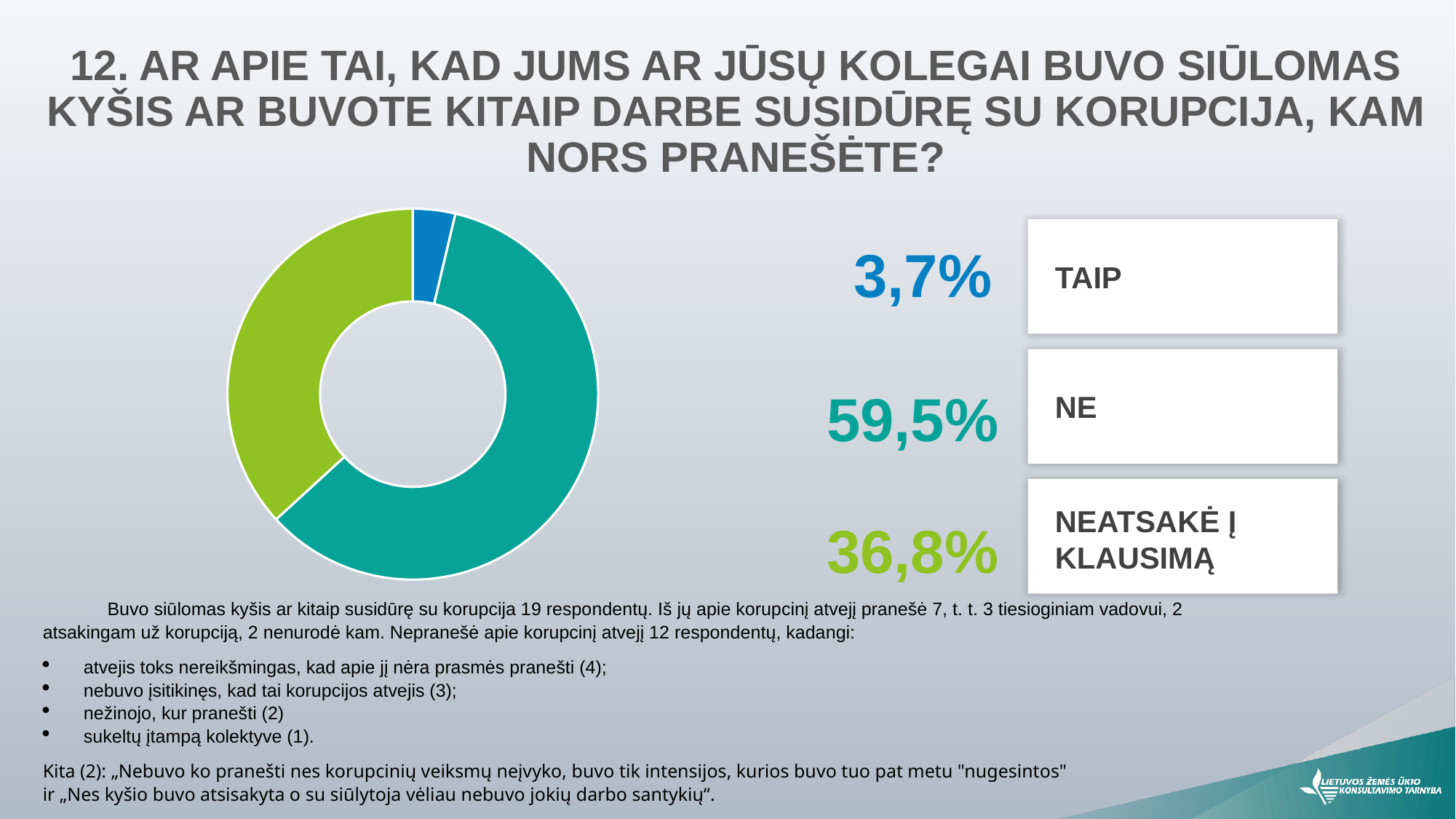
What is the difference in percentage points between the "NEATSAKĖ Į KLAUSIMĄ" and "TAIP" shares? 33,1 What colour is the slice representing "TAIP"? Blue Which answer category has the largest share in the chart? NE How many answer categories are shown in the chart? 3 What is the difference in percentage points between the "NE" and "NEATSAKĖ Į KLAUSIMĄ" shares? 22,7 What share of respondents answered "TAIP"? 3,7% What kind of chart is shown on the slide? Donut (pie) chart Which answer category has the smallest share in the chart? TAIP Which is larger, the share for "NE" or the share for "NEATSAKĖ Į KLAUSIMĄ"? NE What share of respondents answered "NE"? 59,5% What share of respondents did not answer the question ("NEATSAKĖ Į KLAUSIMĄ")? 36,8% What colour is the slice representing "NE"? Teal